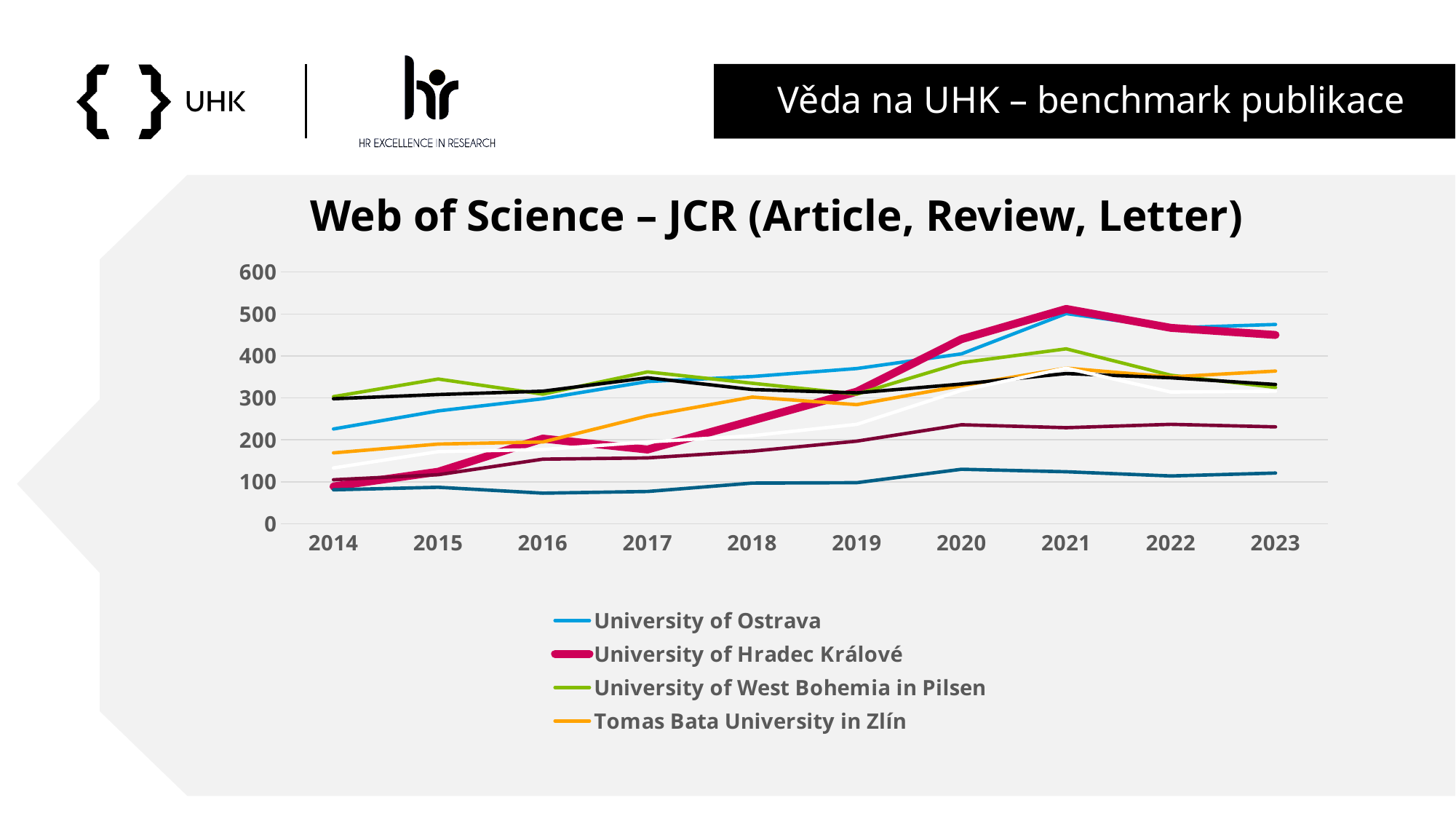
How many series does the chart legend list? 4 In 2014, which is larger: the value for University of Ostrava or the value for University of Hradec Králové? University of Ostrava What is the title of the chart? Web of Science – JCR (Article, Review, Letter) Which years does the x axis of the chart span? 2014 to 2023 What kind of chart is shown on the slide? Line chart Does the value for University of Hradec Králové rise or fall overall from 2014 to 2023? Rise Among the series listed in the legend, which has the lowest value in 2014? University of Hradec Králové Is the value for University of Hradec Králové in 2021 greater or less than 400? greater Is the value for University of Ostrava in 2023 greater or less than 400? greater Is the value for Tomas Bata University in Zlín in 2023 greater or less than 300? greater How many years are shown on the x axis of the chart? 10